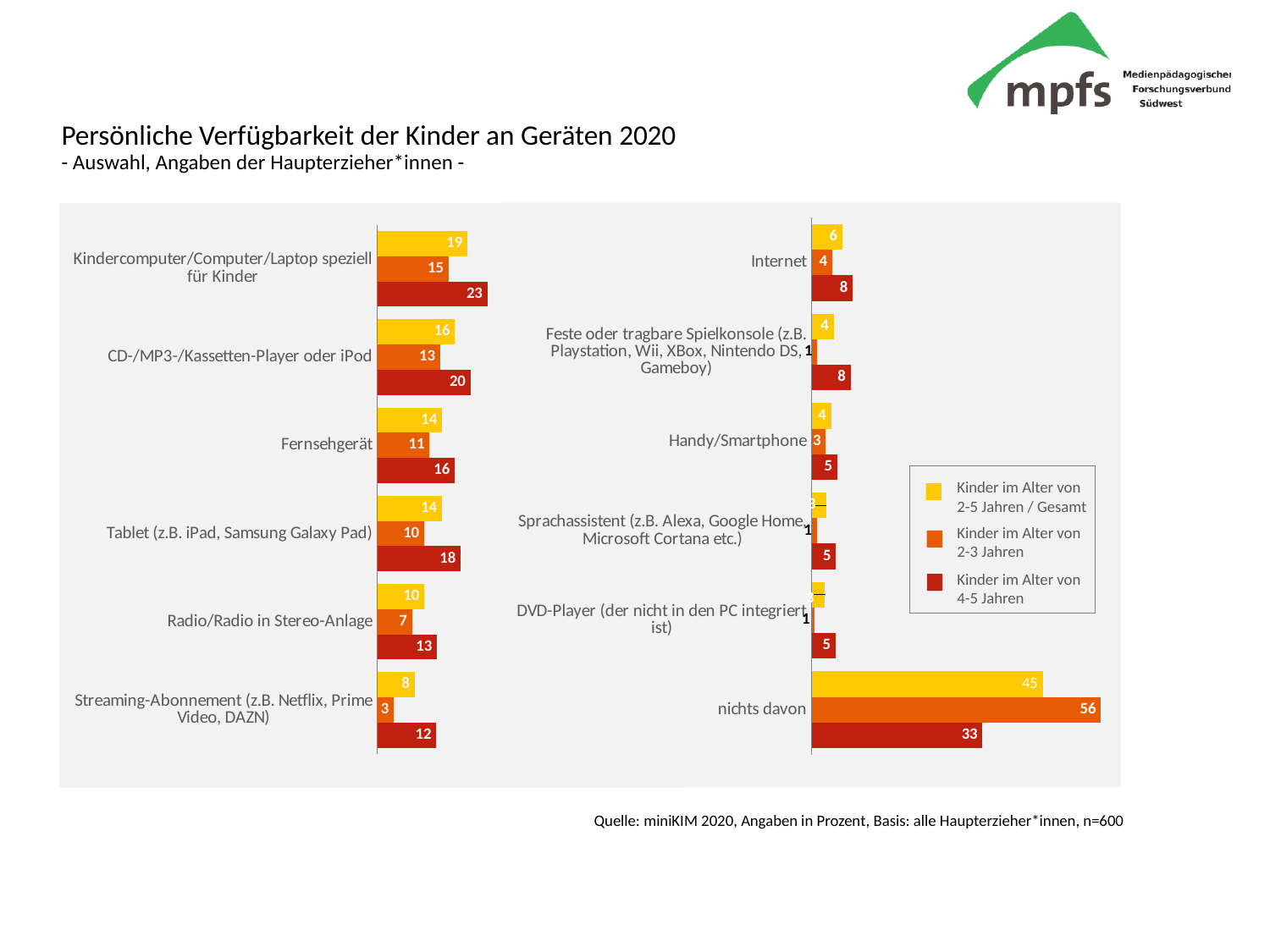
In the right chart, what is the value for nichts davon for Kinder im Alter von 2-3 Jahren? 56 How many categories are shown in the right chart? 6 How many series does the legend list? 3 In the left chart, what is the difference between the 4-5 Jahren and 2-3 Jahren values for Tablet (z.B. iPad, Samsung Galaxy Pad)? 8 In the left chart, what is the value for Fernsehgerät for Kinder im Alter von 2-3 Jahren? 11 In the right chart, what is the difference between the 2-3 Jahren and 4-5 Jahren values for nichts davon? 23 In the left chart, which category has the highest value for Kinder im Alter von 4-5 Jahren? Kindercomputer/Computer/Laptop speziell für Kinder What kind of chart is shown on the left side of the slide? Bar chart In the left chart, which is larger for Radio/Radio in Stereo-Anlage: the value for 2-5 Jahren / Gesamt or the value for 4-5 Jahren? 4-5 Jahren In the left chart, which category has the lowest value for Kinder im Alter von 2-3 Jahren? Streaming-Abonnement (z.B. Netflix, Prime Video, DAZN) In the right chart, what is the value for Internet for Kinder im Alter von 2-5 Jahren / Gesamt? 6 In the left chart, what is the value for Kindercomputer/Computer/Laptop speziell für Kinder for Kinder im Alter von 4-5 Jahren? 23